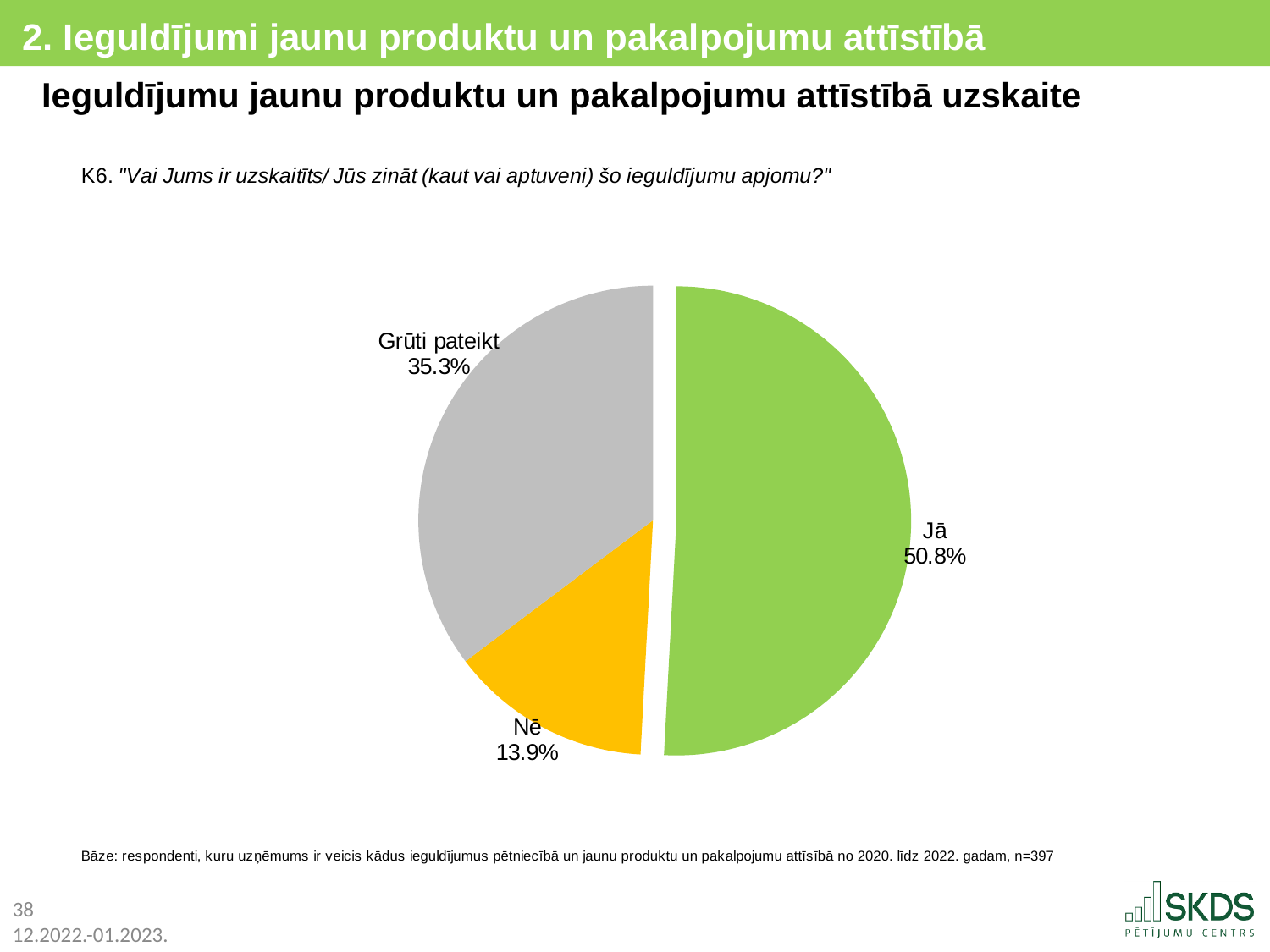
What share of respondents answered "Grūti pateikt"? 35.3% What is the sample size (n) stated in the base note below the chart? 397 What colour is the "Nē" slice? Yellow How many slices does the pie chart have? 3 Which answer has the largest share of the pie? Jā What is the difference in percentage points between "Grūti pateikt" and "Nē"? 21.4 Which answer has the smallest share of the pie? Nē What kind of chart is shown on the slide? Pie chart Which is larger, the share for "Nē" or the share for "Grūti pateikt"? Grūti pateikt What is the difference in percentage points between "Jā" and "Grūti pateikt"? 15.5 What share of respondents answered "Jā"? 50.8% What share of respondents answered "Nē"? 13.9%